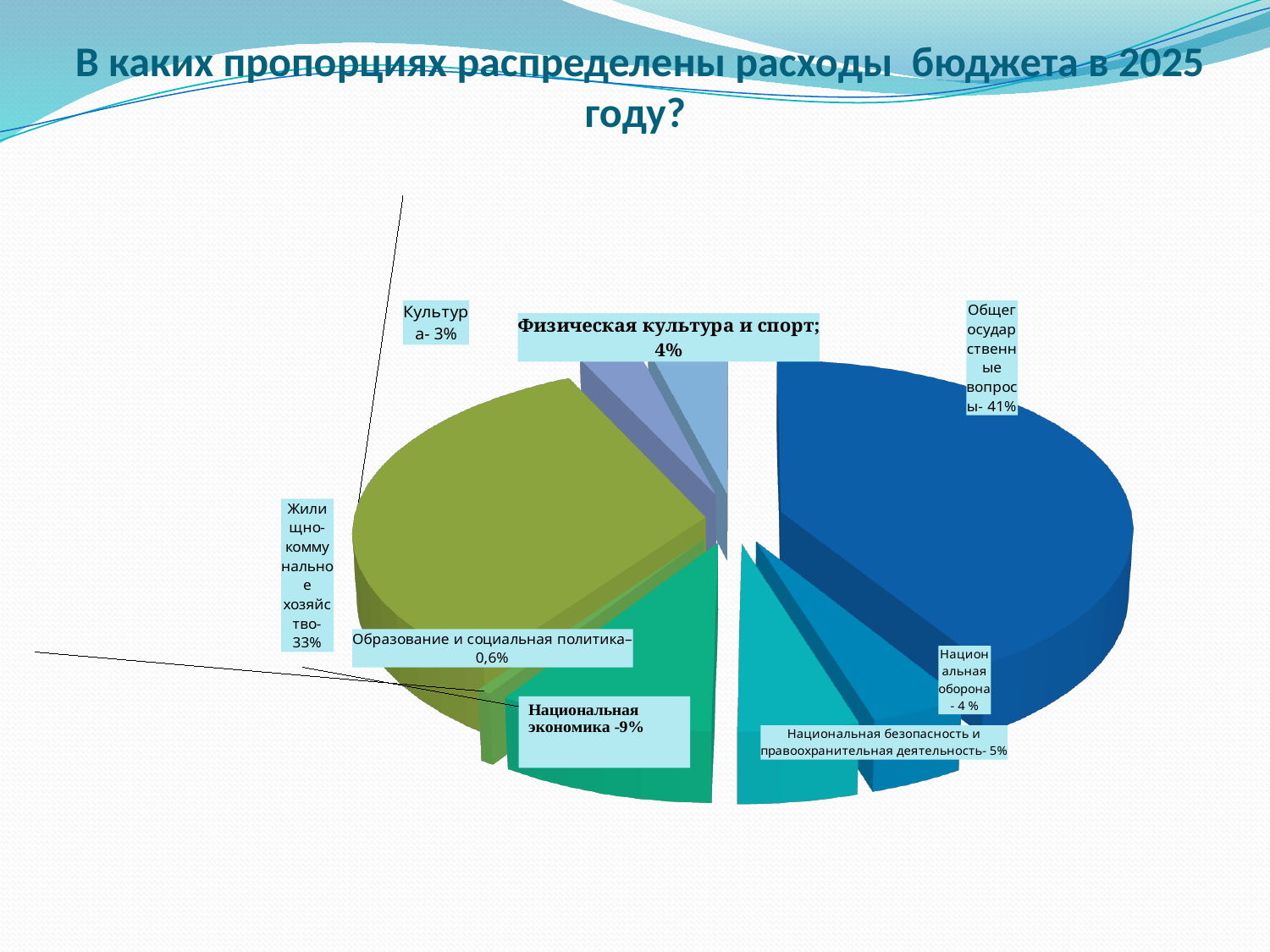
What share is shown for Физическая культура и спорт? 4% How many percentage points larger is the share of Общегосударственные вопросы than that of Жилищно-коммунальное хозяйство? 8 Which category has the smallest share of the budget expenditure? Образование и социальная политика What share is shown for Национальная экономика? 9% How many categories are shown in the pie chart? 8 What share of the budget expenditure goes to Жилищно-коммунальное хозяйство? 33% What type of chart is shown on the slide? Pie chart Which category has the largest share of the budget expenditure? Общегосударственные вопросы What share of the budget expenditure goes to Общегосударственные вопросы? 41% What share is shown for Образование и социальная политика? 0,6% What share is shown for Национальная безопасность и правоохранительная деятельность? 5% Which has a larger share: Национальная экономика or Культура? Национальная экономика